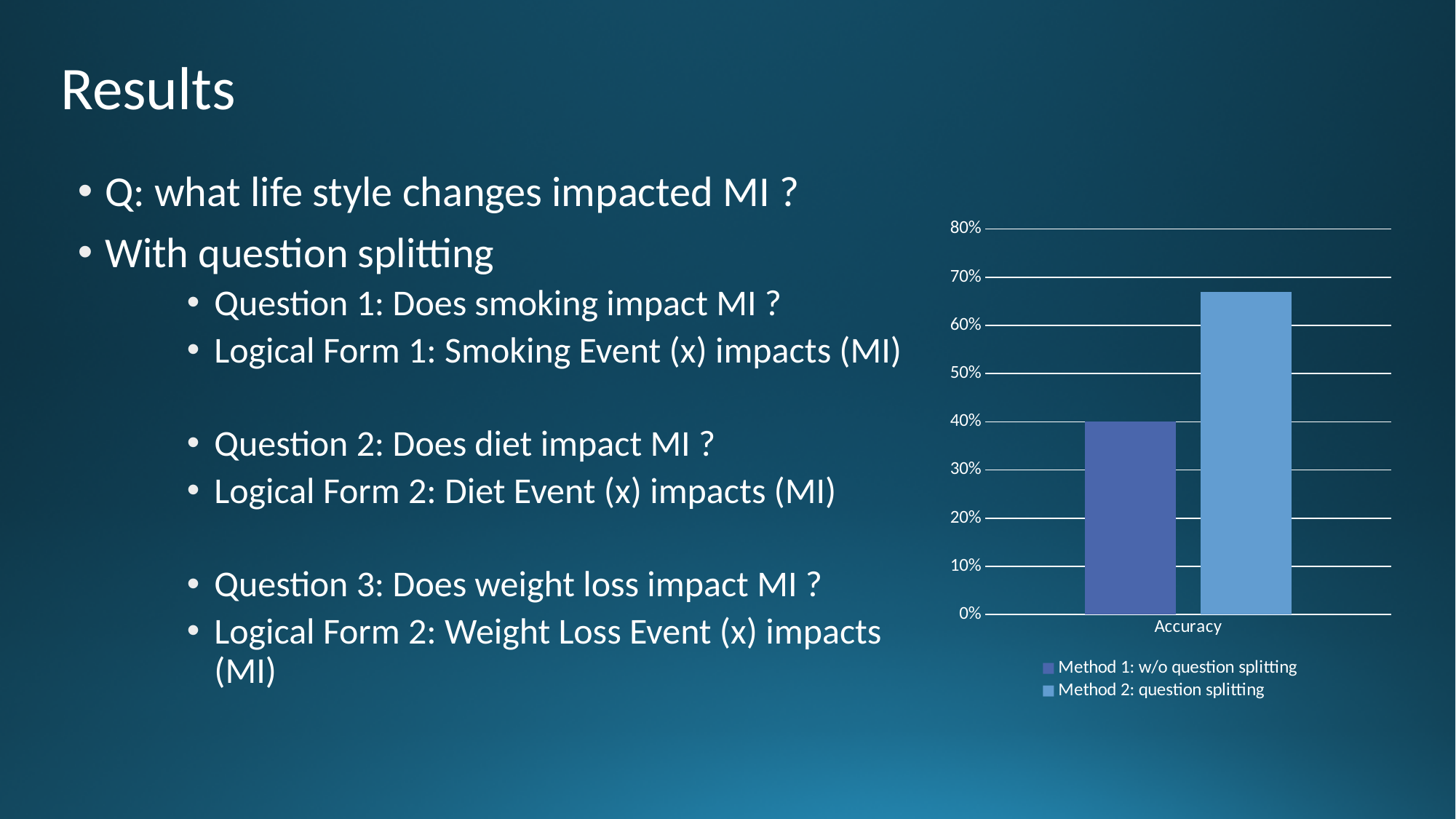
Which method has the higher accuracy in the chart? Method 2: question splitting Is the accuracy value for Method 2: question splitting greater or less than 60%? greater Which method has the lower accuracy in the chart? Method 1: w/o question splitting What is the category label on the x axis of the chart? Accuracy Which is larger: the accuracy for Method 1: w/o question splitting or for Method 2: question splitting? Method 2: question splitting What is the highest value shown on the chart's y axis? 80% How many categories are shown on the x axis of the chart? 1 Is the accuracy value for Method 1: w/o question splitting greater or less than 50%? less What is the accuracy value for Method 1: w/o question splitting? 40% How many series does the chart legend list? 2 Is the accuracy value for Method 2: question splitting greater or less than 70%? less What kind of chart is shown on the slide? bar chart